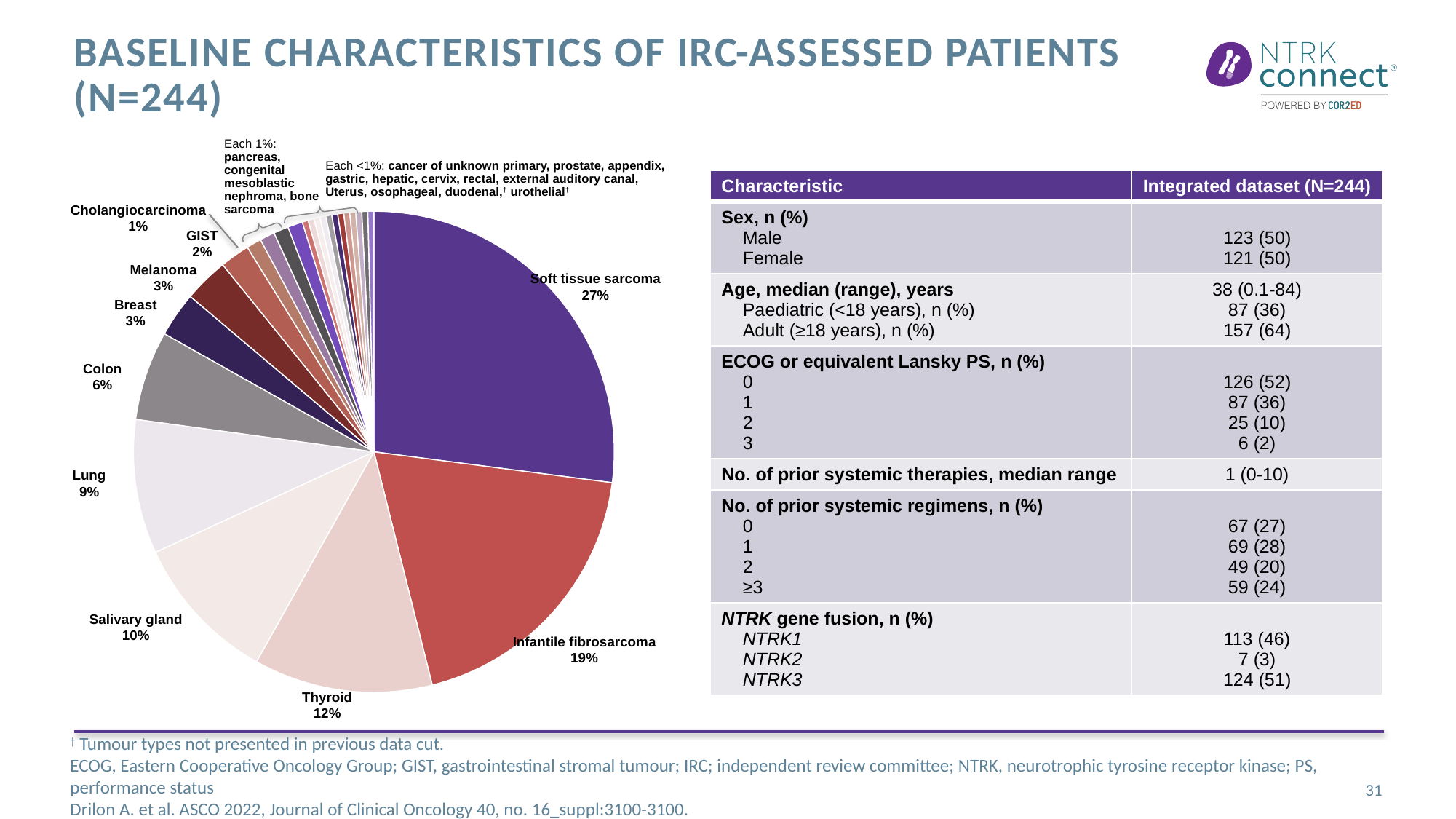
Which tumour type has the largest slice in the pie chart? Soft tissue sarcoma What type of chart is shown on the left of the slide? Pie chart What share of the pie chart is Soft tissue sarcoma? 27% What percentage is shown for Salivary gland in the pie chart? 10% What percentage is shown for GIST in the pie chart? 2% What percentage is shown for Infantile fibrosarcoma in the pie chart? 19% Which tumour types are listed in the pie chart as each accounting for 1%? Pancreas, congenital mesoblastic nephroma, bone sarcoma Which has a larger share in the pie chart, Lung or Colon? Lung What is the combined percentage of Breast and Melanoma in the pie chart? 6% What is the difference in percentage points between Soft tissue sarcoma and Infantile fibrosarcoma in the pie chart? 8 What percentage is shown for Thyroid in the pie chart? 12% What percentage is shown for Cholangiocarcinoma in the pie chart? 1%